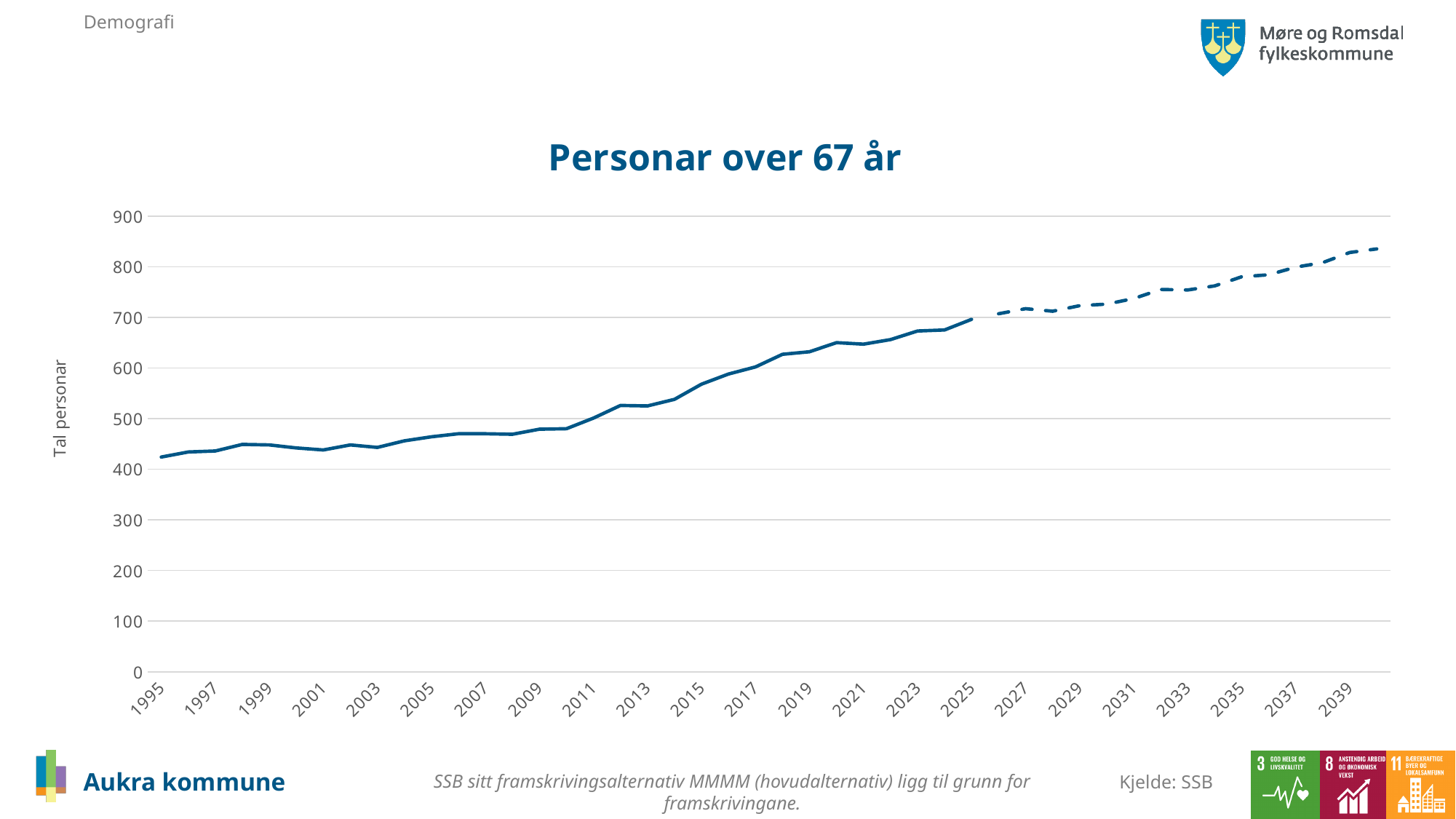
What kind of chart is shown on the slide? line chart Is the value for 2019 greater or less than 600? greater Is the value for 2021 larger or smaller than the value for 2005? larger Which year has the lowest value in the chart? 1995 Do the values in the chart generally rise or fall from 1995 to 2040? rise What is the title of the chart? Personar over 67 år Is the value for 2033 greater or less than 700? greater Is the value for 2013 greater or less than 500? greater Which year has the highest value in the chart? 2040 What is the label on the vertical axis of the chart? Tal personar